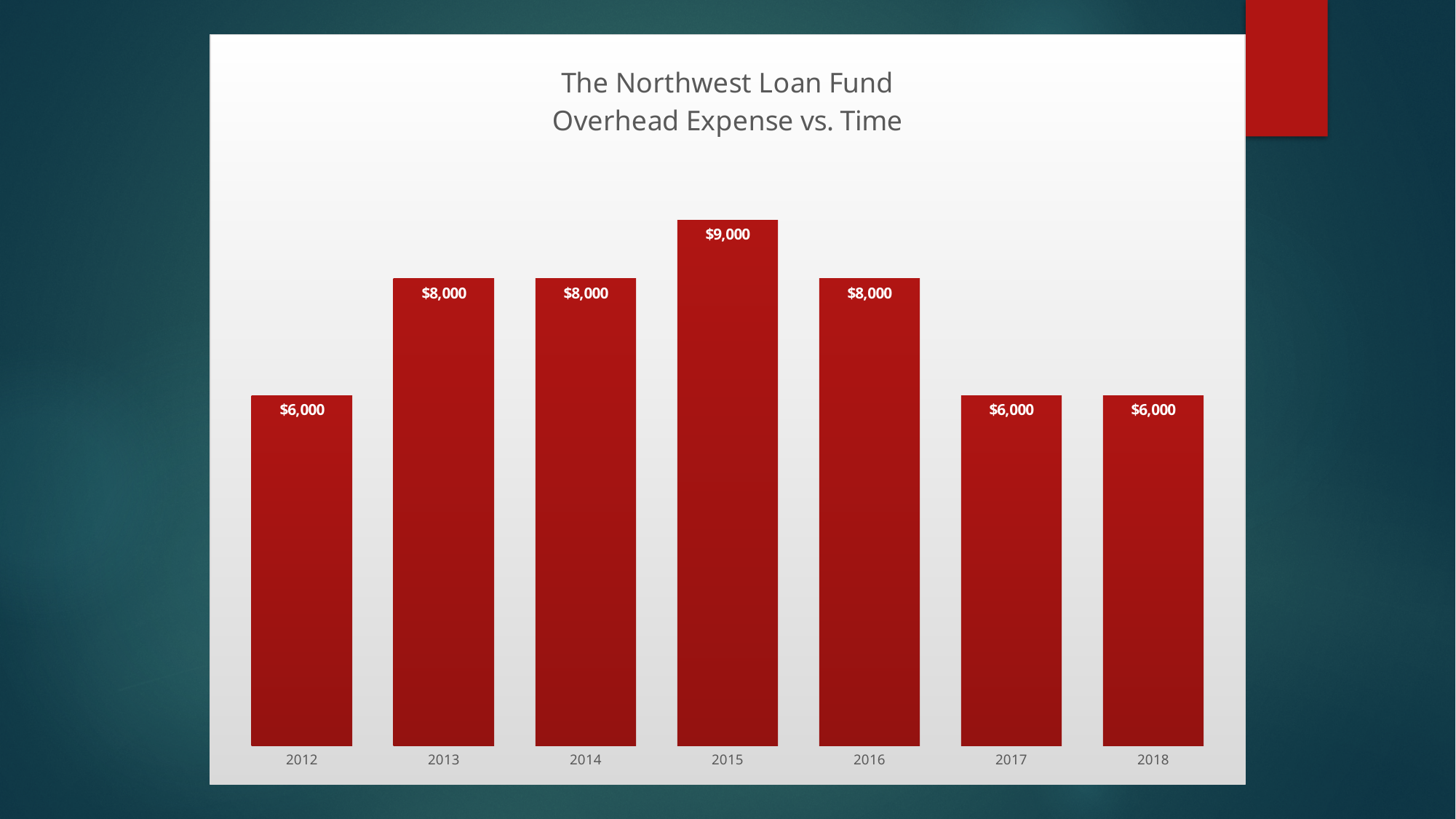
What is the difference between the overhead expense in 2013 and in 2017? $2,000 What is the difference between the overhead expense in 2015 and in 2012? $3,000 What is the overhead expense for 2012? $6,000 What is the overhead expense for 2015? $9,000 Which year has the highest overhead expense? 2015 What kind of chart is shown on the slide? Bar chart Which is larger, the overhead expense in 2014 or in 2018? 2014 What colour are the bars in the chart? Red What is the overhead expense for 2016? $8,000 What is the title of the chart? The Northwest Loan Fund Overhead Expense vs. Time Does the overhead expense rise or fall from 2015 to 2018? Fall How many years are shown on the x axis? 7